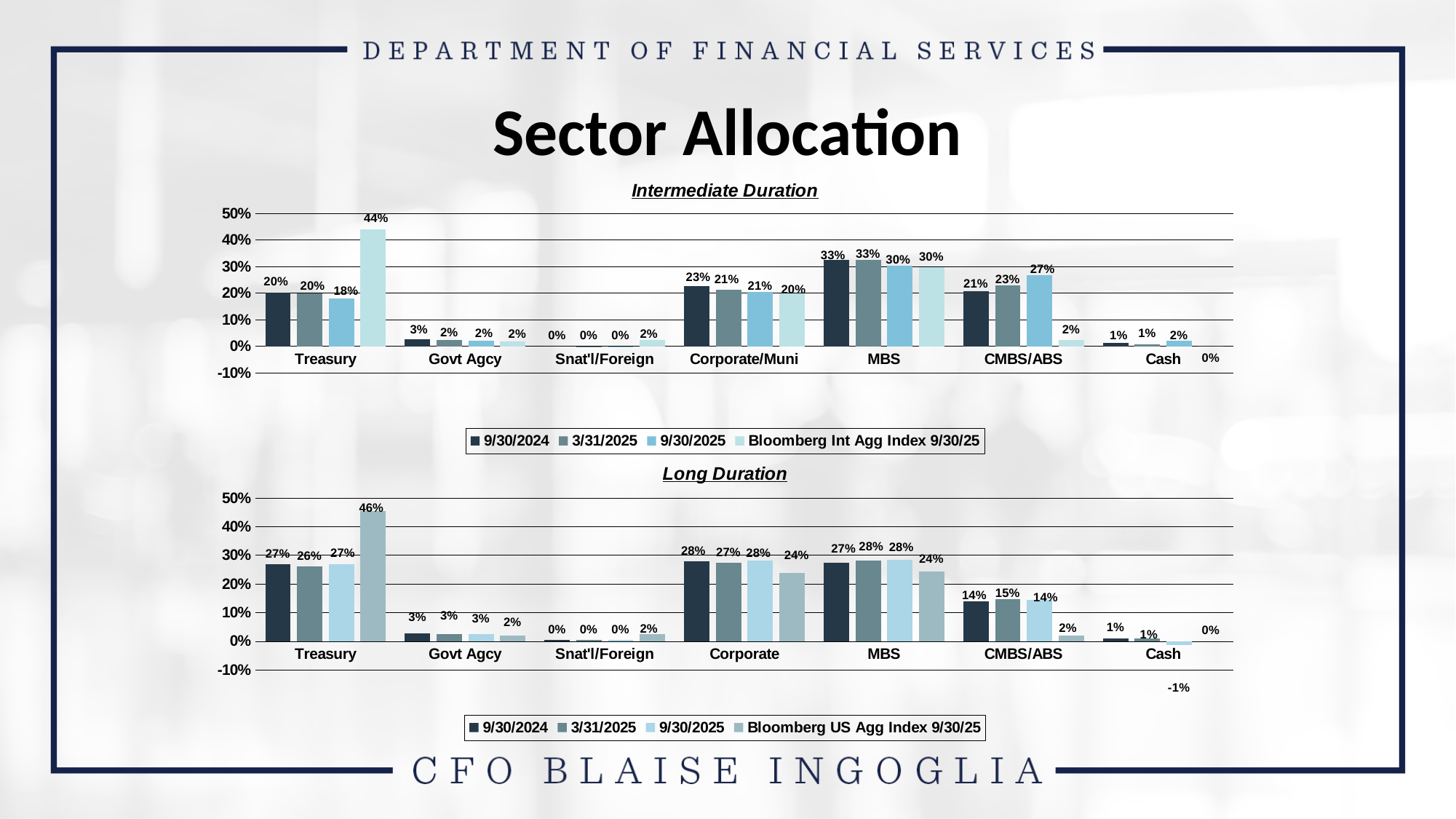
In the Long Duration chart, what is the 9/30/2025 value for Cash? -1% What kind of chart is the Long Duration chart? Bar chart In the Intermediate Duration chart, what is the Bloomberg Int Agg Index 9/30/25 value for Treasury? 44% In the Intermediate Duration chart, what is the 9/30/2024 value for Corporate/Muni? 23% In the Intermediate Duration chart, what is the 9/30/2025 value for CMBS/ABS? 27% In the Long Duration chart, how many categories are shown on the x axis? 7 In the Long Duration chart, what is the difference between the 9/30/2024 value for Corporate and the Bloomberg US Agg Index 9/30/25 value for Corporate? 4% In the Intermediate Duration chart, how many series does the legend list? 4 In the Intermediate Duration chart, what is the difference between the 9/30/2024 and 9/30/2025 values for MBS? 3% In the Long Duration chart, what is the Bloomberg US Agg Index 9/30/25 value for Treasury? 46% In the Intermediate Duration chart, which category has the highest 9/30/2024 value? MBS In the Long Duration chart, which is larger for CMBS/ABS: the 3/31/2025 value or the Bloomberg US Agg Index 9/30/25 value? 3/31/2025